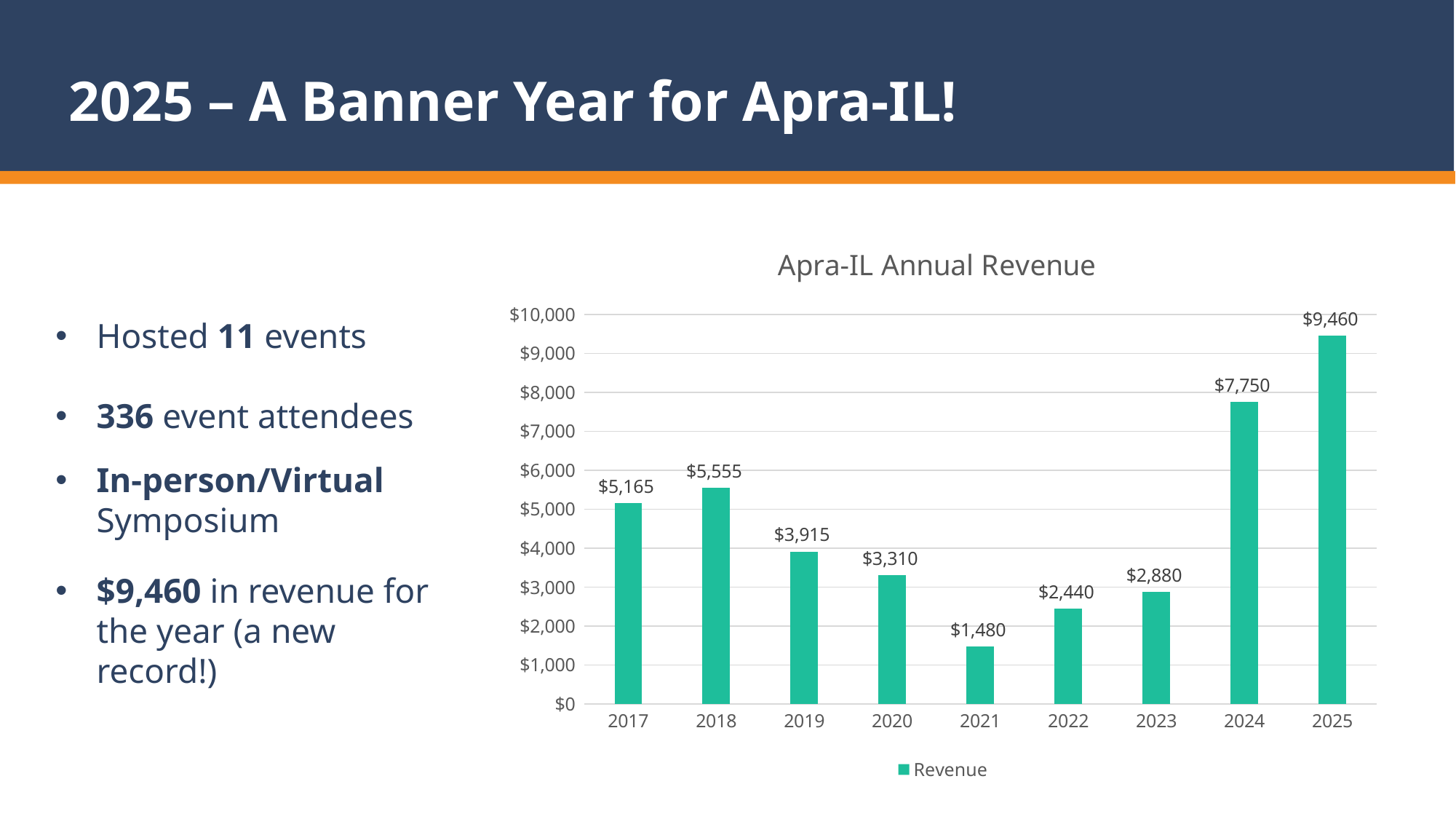
Is the revenue for 2022 greater or less than $3,000? less Which year has the highest revenue in the Apra-IL Annual Revenue chart? 2025 What is the difference in revenue between 2018 and 2017? $390 What is the revenue for 2019 in the Apra-IL Annual Revenue chart? $3,915 Does revenue rise or fall from 2021 to 2025 in the Apra-IL Annual Revenue chart? rise Which year had higher revenue, 2020 or 2023? 2020 What is the revenue for 2021 in the Apra-IL Annual Revenue chart? $1,480 What is the difference in revenue between 2025 and 2024? $1,710 How many years are shown in the Apra-IL Annual Revenue chart? 9 Which year has the lowest revenue in the Apra-IL Annual Revenue chart? 2021 How many series does the legend of the Apra-IL Annual Revenue chart list? 1 What kind of chart is the Apra-IL Annual Revenue chart? bar chart